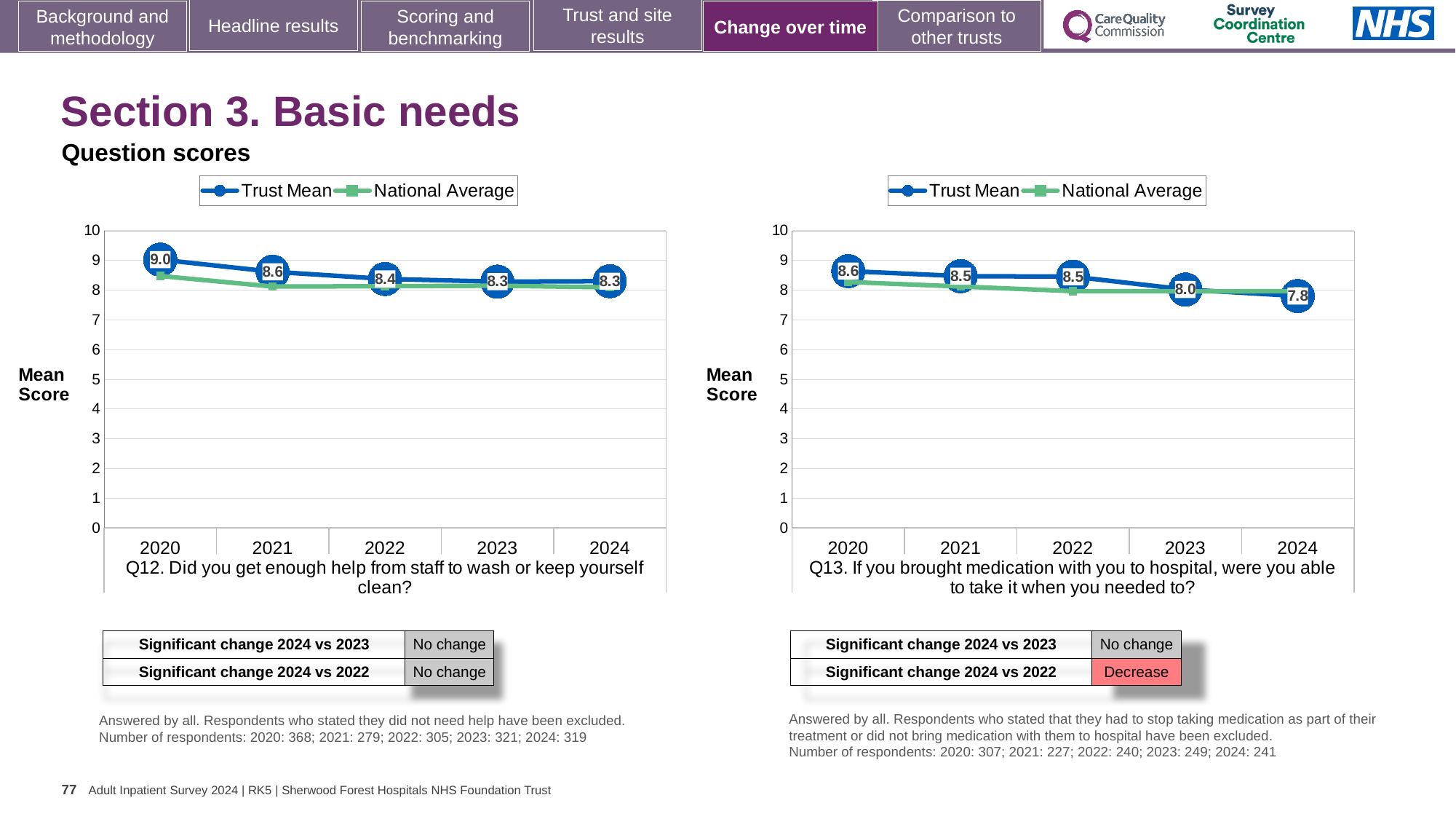
In the Q12 chart (left), does the Trust Mean score rise or fall from 2020 to 2024? Fall What kind of chart is the Q12 chart (left)? Line chart In the Q12 chart (left), what is the Trust Mean score for 2020? 9.0 In the Q13 chart (right), what is the Trust Mean score for 2023? 8.0 In the Q12 chart (left), which year has the highest Trust Mean score? 2020 Is the Trust Mean score for 2024 in the Q12 chart (left) or the Trust Mean score for 2024 in the Q13 chart (right) larger? Q12 chart (left) In the Q12 chart (left), what is the difference between the Trust Mean scores for 2020 and 2024? 0.7 In the Q13 chart (right), which year has the lowest Trust Mean score? 2024 In the Q13 chart (right), what is the difference between the Trust Mean scores for 2020 and 2024? 0.8 How many series does the legend of the Q13 chart (right) list? 2 In the Q12 chart (left), what is the Trust Mean score for 2024? 8.3 In the Q13 chart (right), what is the Trust Mean score for 2024? 7.8